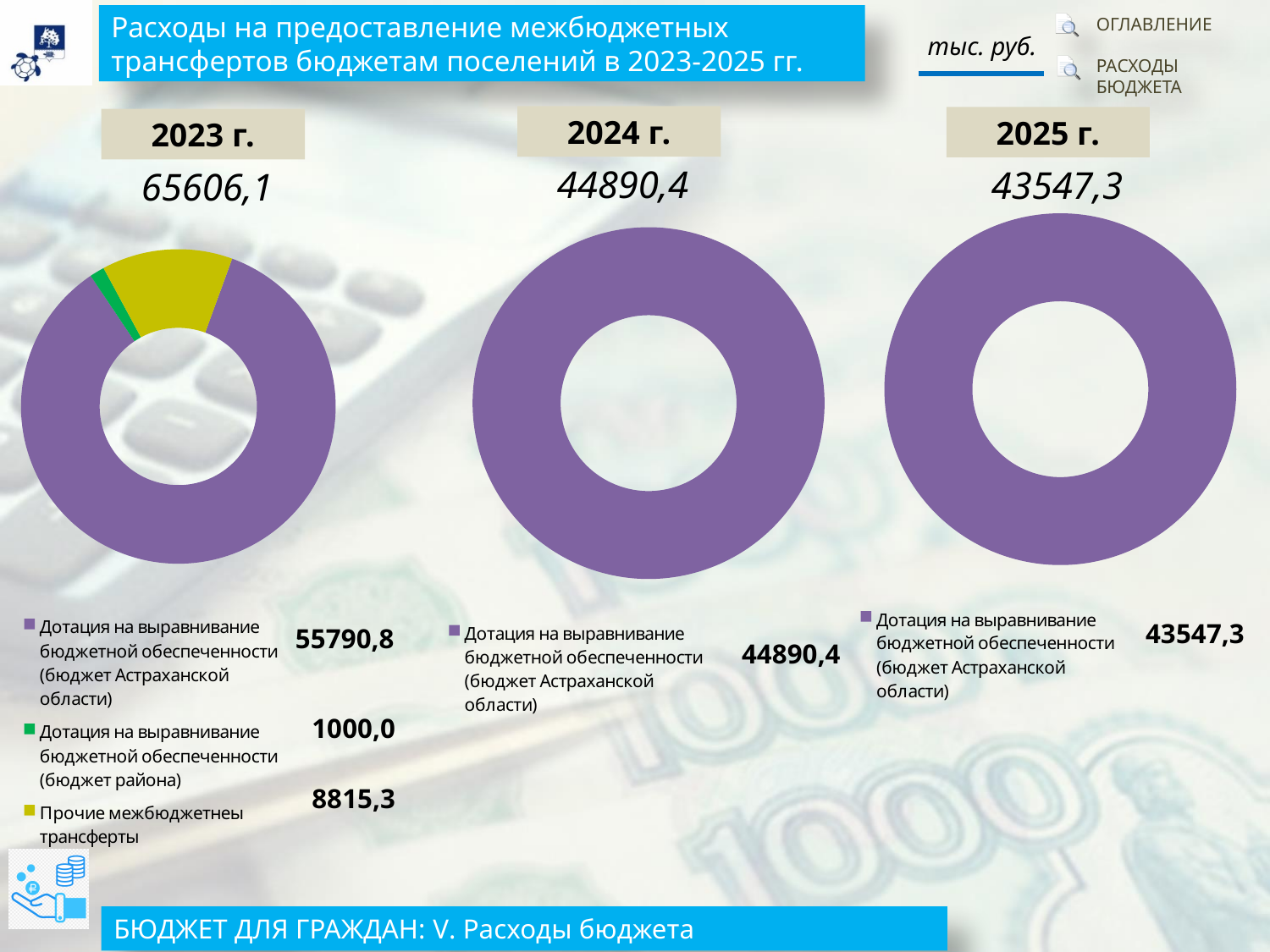
How many categories are shown in the 2023 г. chart? 3 How many categories are shown in the 2024 г. chart? 1 Which year has the larger total of transfers, 2024 г. or 2025 г.? 2024 г. In the 2023 г. chart, what is the value for Дотация на выравнивание бюджетной обеспеченности (бюджет района)? 1000,0 In the 2023 г. chart, which category has the largest value? Дотация на выравнивание бюджетной обеспеченности (бюджет Астраханской области) Do the yearly totals rise or fall from 2023 г. to 2025 г.? fall In the 2025 г. chart, what is the value for Дотация на выравнивание бюджетной обеспеченности (бюджет Астраханской области)? 43547,3 In the 2023 г. chart, which category has the smallest value? Дотация на выравнивание бюджетной обеспеченности (бюджет района) In the 2023 г. chart, what is the difference between Дотация на выравнивание бюджетной обеспеченности (бюджет Астраханской области) and Прочие межбюджетные трансферты? 46975,5 In the 2023 г. chart, what is the value for Прочие межбюджетные трансферты? 8815,3 What kind of chart is used for each year on this slide? doughnut chart What is the total value shown for the 2023 г. chart? 65606,1